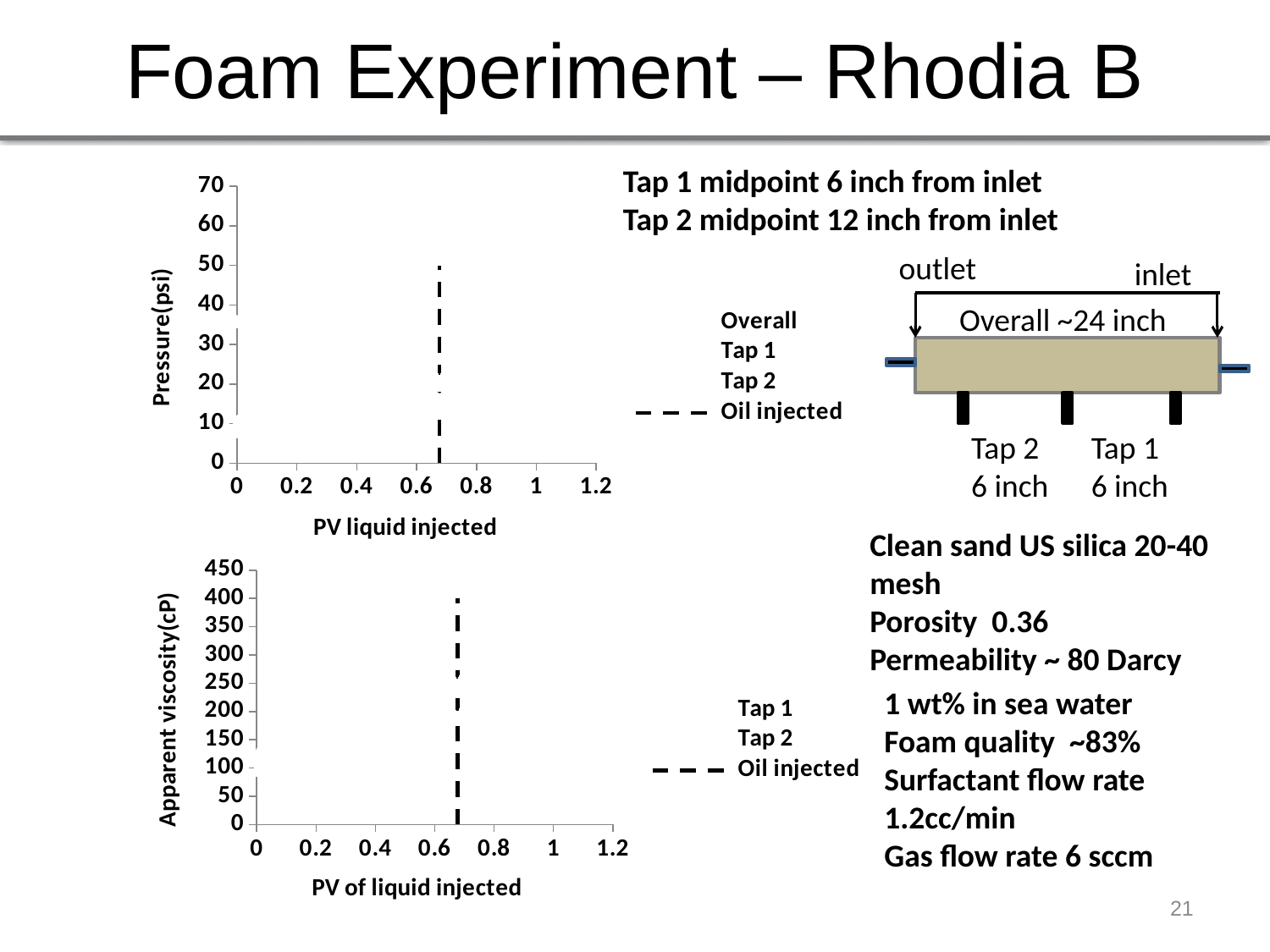
What is the y-axis label of the top chart? Pressure(psi) In the top chart, is the PV liquid injected value at which the Oil injected dashed line is drawn greater or less than 0.6? greater What kind of chart is the top chart? line chart In the bottom chart, is the PV of liquid injected value at which the Oil injected dashed line is drawn greater or less than 0.8? less In the top chart, which legend entry is drawn as a dashed line? Oil injected What is the y-axis label of the bottom chart? Apparent viscosity(cP) In the bottom chart (Apparent viscosity(cP) vs PV of liquid injected), how many series does the legend list? 3 In the top chart (Pressure(psi) vs PV liquid injected), how many series does the legend list? 4